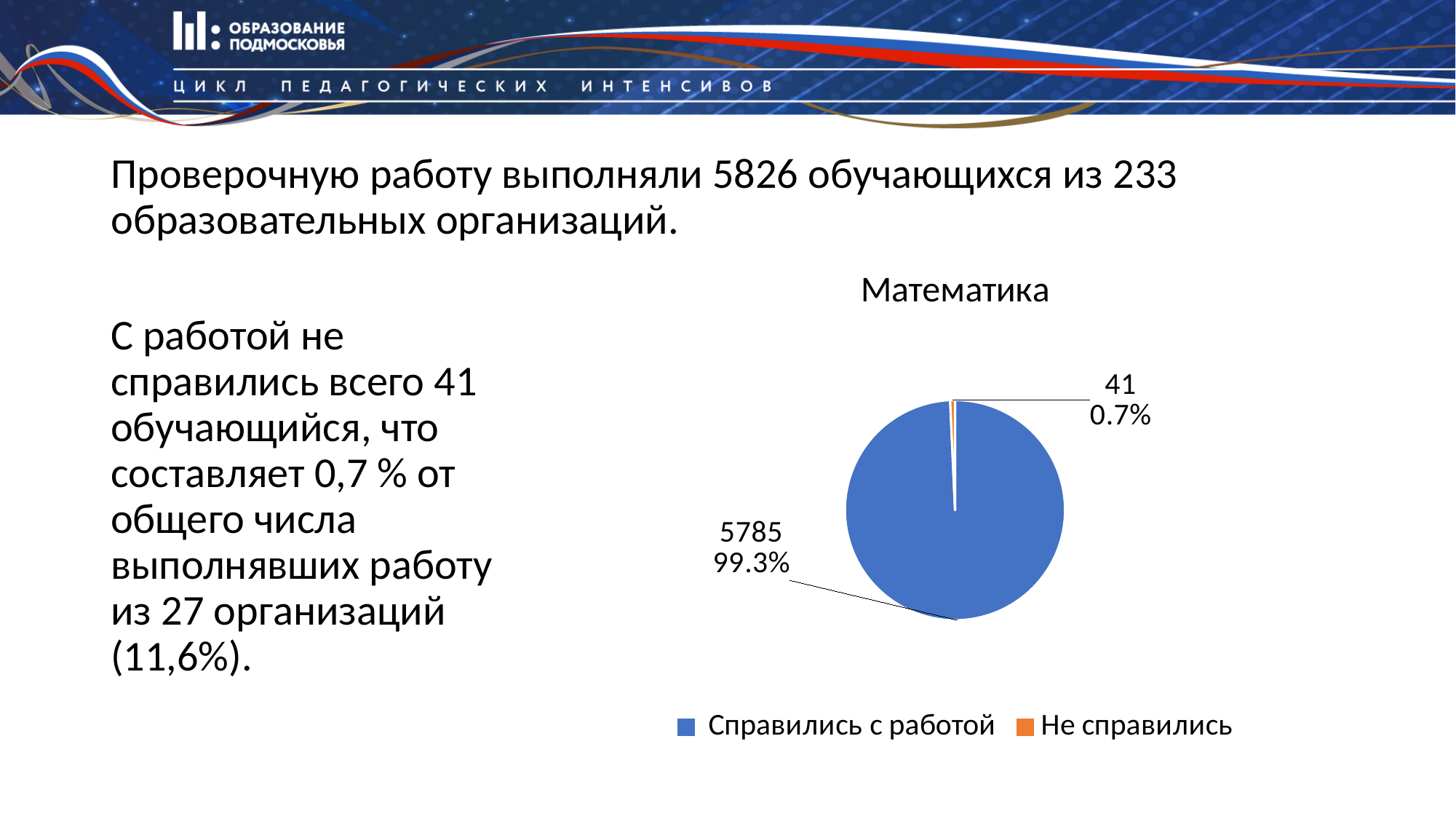
What is the title of the chart? Математика What is the value for 'Не справились'? 41 Which category has the smallest slice? Не справились What is the value for 'Справились с работой'? 5785 What share of the pie does 'Не справились' represent? 0.7% How many slices does the pie chart have? 2 What is the difference between the values for 'Справились с работой' and 'Не справились'? 5744 Which category has the largest slice? Справились с работой What share of the pie does 'Справились с работой' represent? 99.3% What type of chart is shown on the slide? pie chart How many entries does the chart legend list? 2 Which colour represents 'Не справились' in the chart? orange